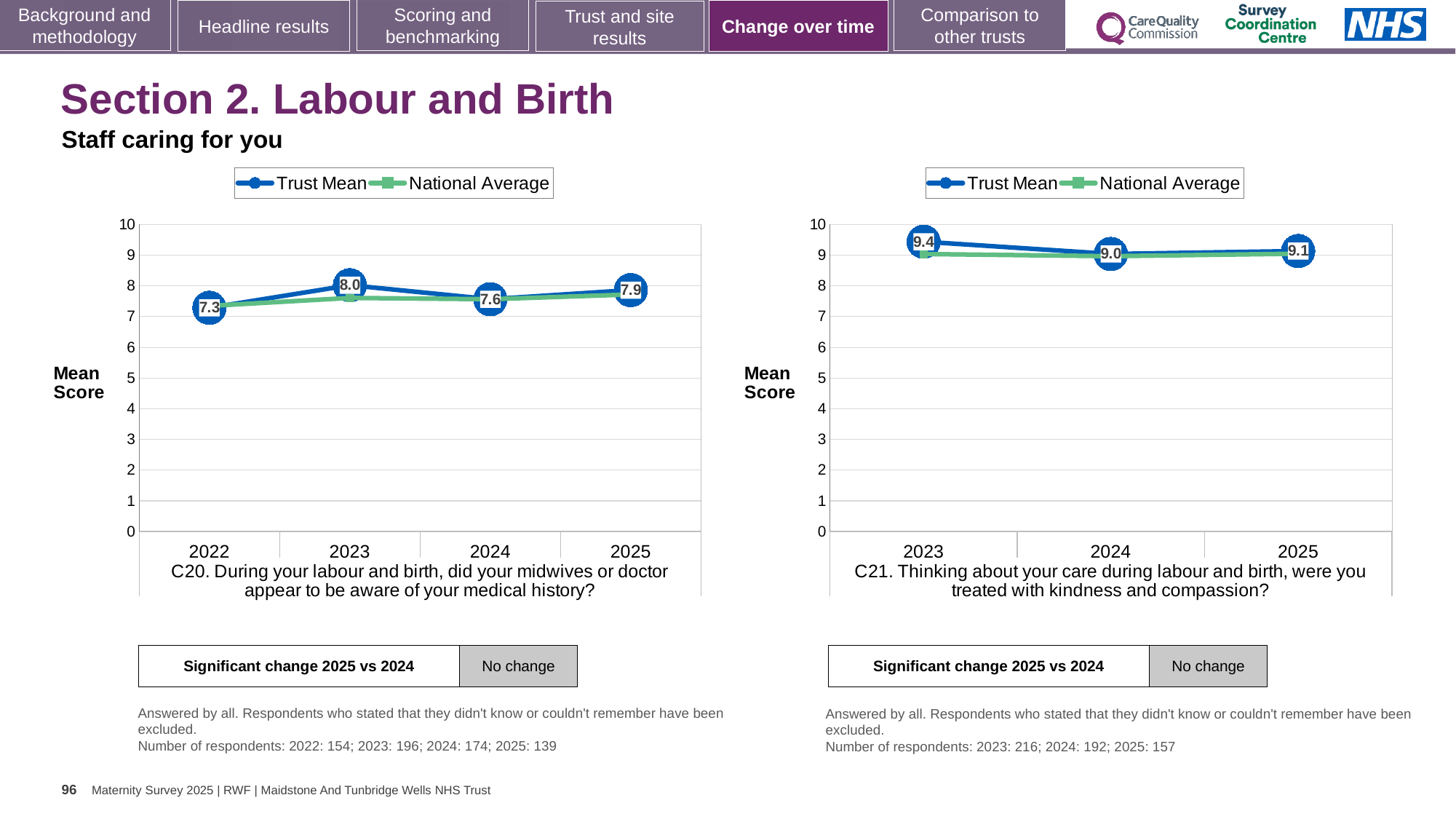
In the C21 chart on the right, which year has the highest Trust Mean? 2023 In the C21 chart on the right, what is the difference between the Trust Mean for 2023 and 2024? 0.4 What kind of chart is the C20 chart on the left? Line chart In the C20 chart on the left, what is the difference between the Trust Mean for 2023 and 2022? 0.7 In the C20 chart on the left, which year has the highest Trust Mean? 2023 In the C20 chart on the left, what is the Trust Mean for 2023? 8.0 How many series does the legend of the C20 chart on the left list? 2 In the C20 chart on the left, is the Trust Mean higher in 2025 or in 2024? 2025 In the C20 chart on the left, which year has the lowest Trust Mean? 2022 How many years are plotted on the x axis of the C21 chart on the right? 3 In the C21 chart on the right, what is the Trust Mean for 2025? 9.1 In the C20 chart on the left, what is the Trust Mean for 2022? 7.3